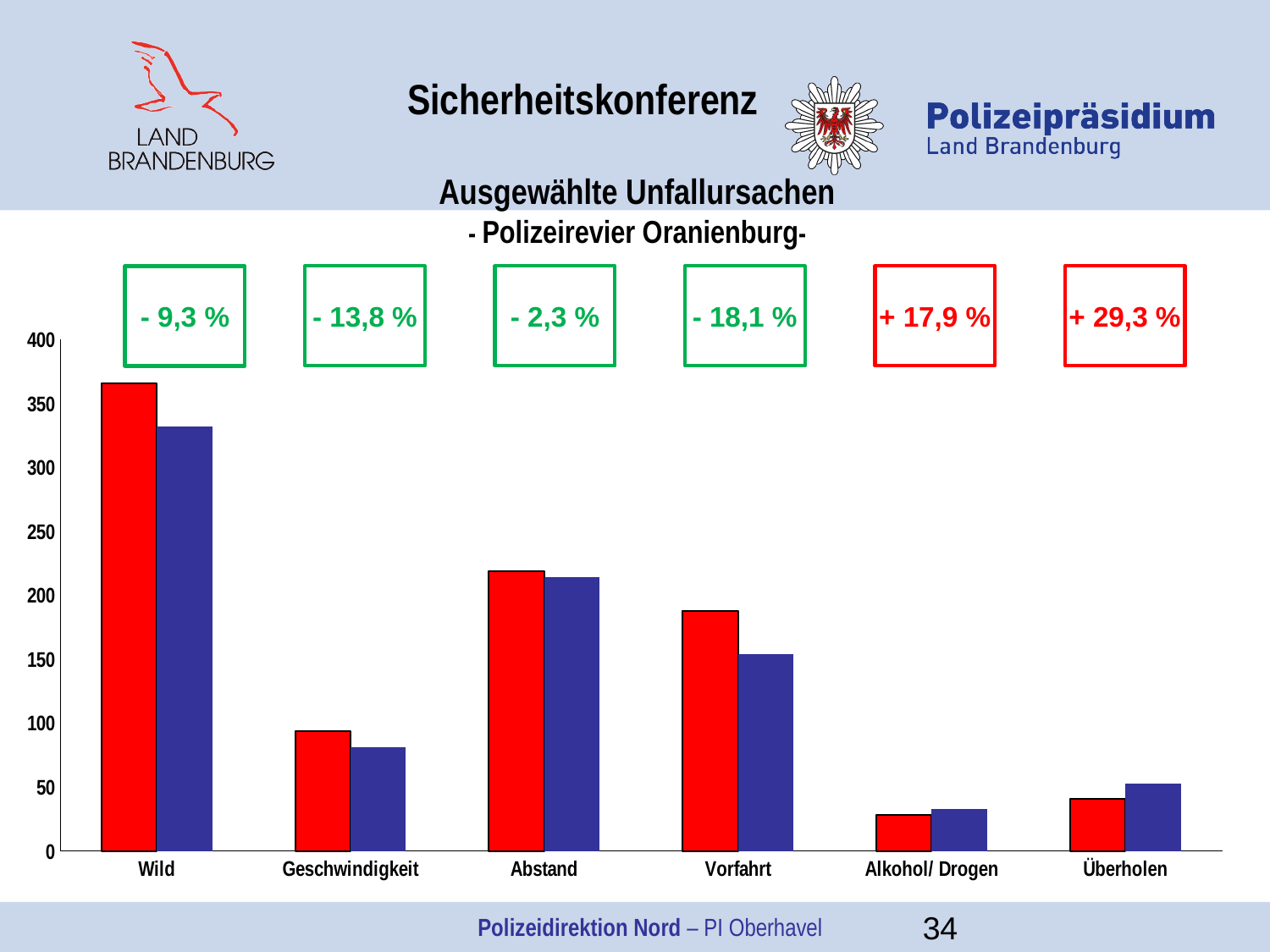
Is the value of the red bar for Abstand greater or less than 200? greater Which category has the highest bars in the chart? Wild What percentage change is shown in the box above the Vorfahrt category? - 18,1 % Which category has the lowest bars in the chart? Alkohol/ Drogen What percentage change is shown in the box above the Überholen category? + 29,3 % What kind of chart is shown on the slide? bar chart Is the value of the blue bar for Vorfahrt greater or less than 150? greater Is the value of the blue bar for Geschwindigkeit greater or less than 100? less For Vorfahrt, which bar is larger, the red one or the blue one? red How many categories are shown on the x axis of the chart? 6 For Überholen, which bar is larger, the red one or the blue one? blue